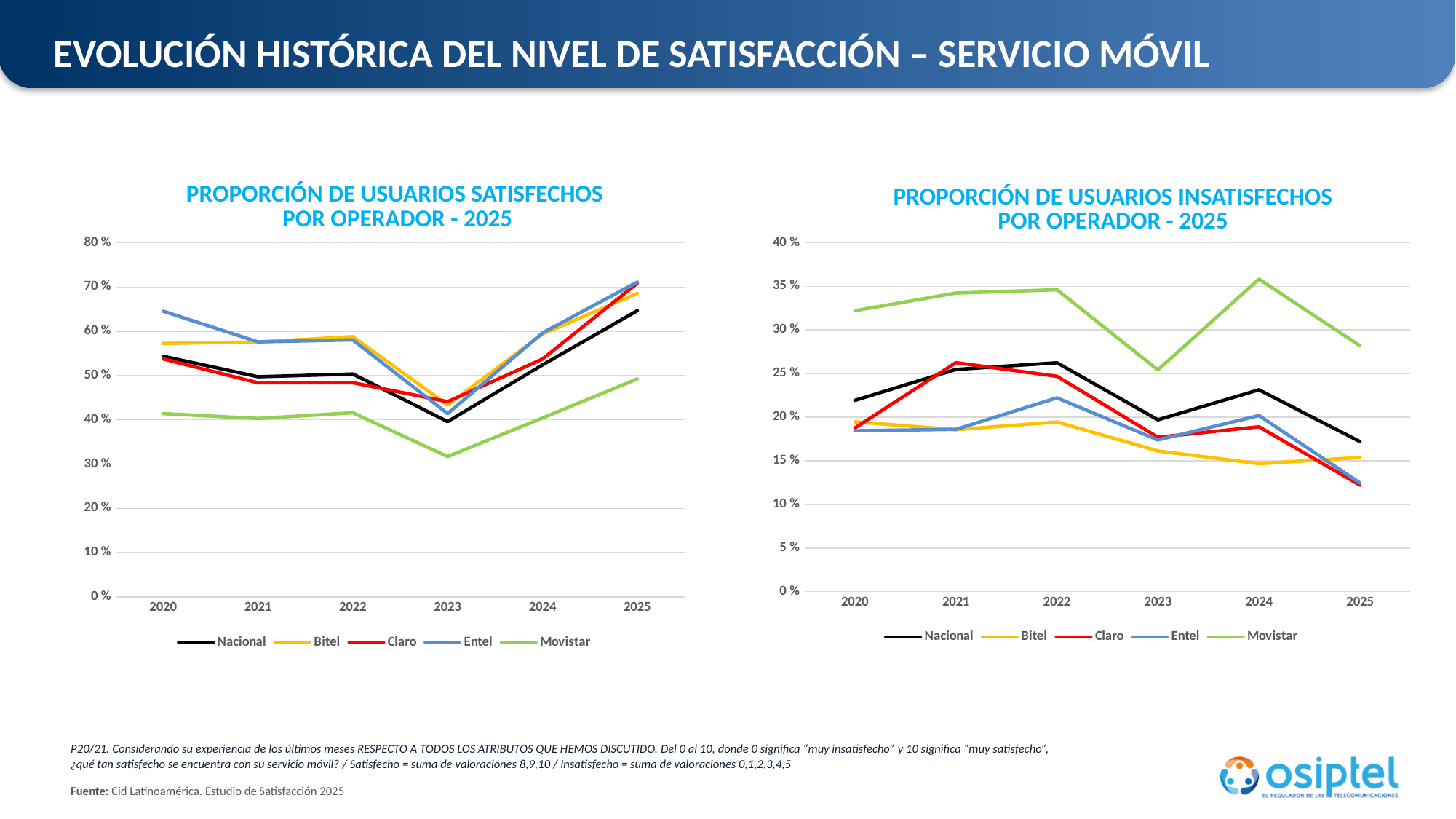
In the left chart, 'Proporción de usuarios satisfechos por operador - 2025', which colour is used for the Nacional series? Black How many years are shown on the x axis of the left chart, 'Proporción de usuarios satisfechos por operador - 2025'? 6 In the right chart, 'Proporción de usuarios insatisfechos por operador - 2025', which operator has the lowest value in 2024? Bitel In the left chart, 'Proporción de usuarios satisfechos por operador - 2025', is the value for Movistar in 2023 greater or less than 40 %? less In the left chart, 'Proporción de usuarios satisfechos por operador - 2025', is the value for Entel in 2020 greater or less than 60 %? greater In the right chart, 'Proporción de usuarios insatisfechos por operador - 2025', does the Movistar line rise or fall from 2024 to 2025? Fall In the right chart, 'Proporción de usuarios insatisfechos por operador - 2025', is the value for Claro in 2025 greater or less than 15 %? less What kind of chart is the left chart, 'Proporción de usuarios satisfechos por operador - 2025'? Line chart In the right chart, 'Proporción de usuarios insatisfechos por operador - 2025', which operator has the highest value in 2024? Movistar In the left chart, 'Proporción de usuarios satisfechos por operador - 2025', which series has the highest value in 2020? Entel In the left chart, 'Proporción de usuarios satisfechos por operador - 2025', which operator has the lowest value in 2023? Movistar How many series does the legend of the right chart, 'Proporción de usuarios insatisfechos por operador - 2025', list? 5